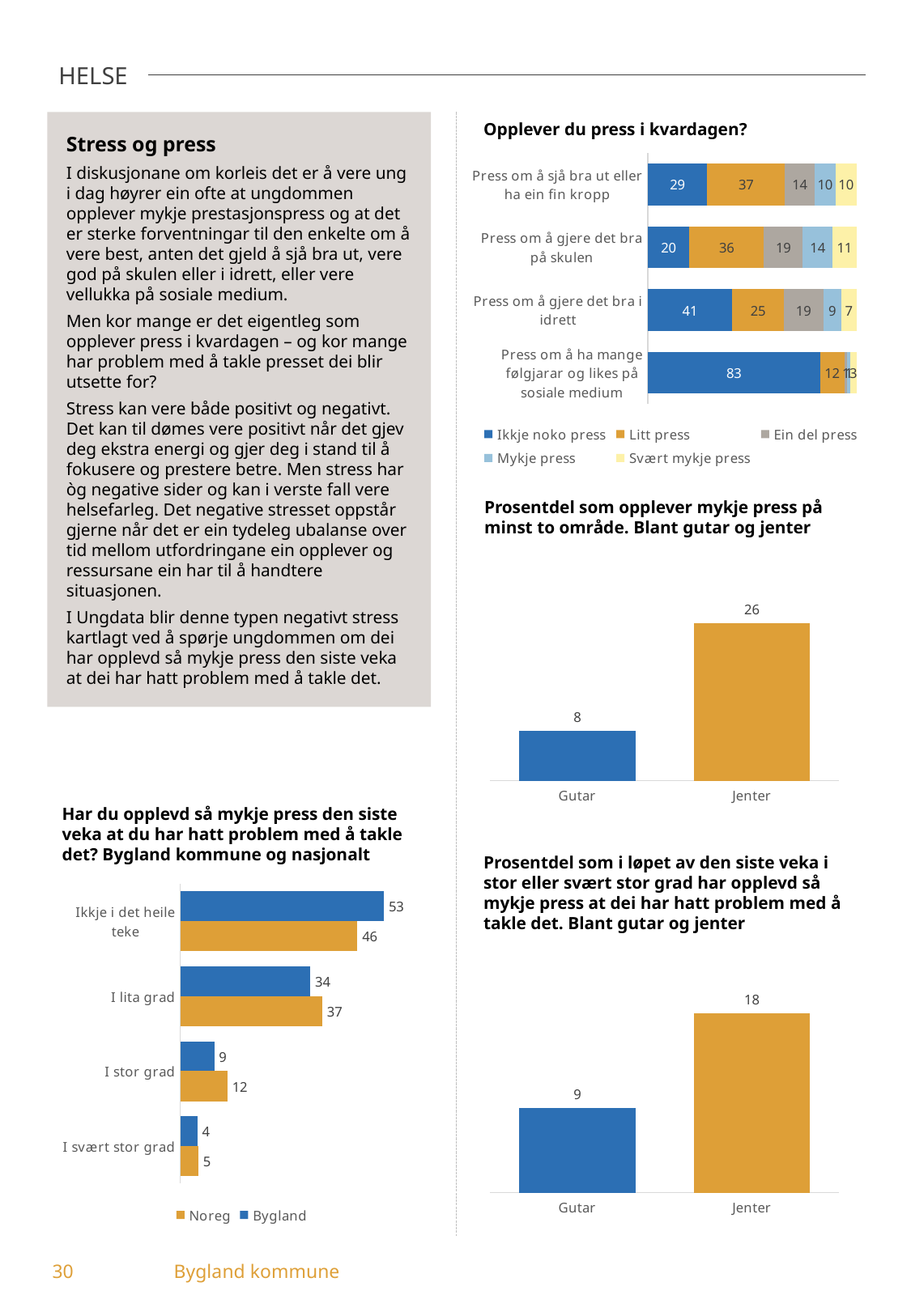
In the chart 'Prosentdel som i løpet av den siste veka i stor eller svært stor grad har opplevd så mykje press...', what is the value for Gutar? 9 In the chart 'Opplever du press i kvardagen?', what is the value for 'Litt press' for 'Press om å gjere det bra på skulen'? 36 In the chart 'Opplever du press i kvardagen?', what is the value for 'Ikkje noko press' for 'Press om å ha mange følgjarar og likes på sosiale medium'? 83 In the chart 'Opplever du press i kvardagen?', how many series does the legend list? 5 In the chart 'Prosentdel som opplever mykje press på minst to område', what is the value for Jenter? 26 In the chart 'Har du opplevd så mykje press den siste veka...', how many categories are shown? 4 In the chart 'Har du opplevd så mykje press den siste veka...', which category has the highest value for Bygland? Ikkje i det heile teke In the chart 'Opplever du press i kvardagen?', what is the total of the stacked bar for 'Press om å sjå bra ut eller ha ein fin kropp'? 100 In the chart 'Har du opplevd så mykje press den siste veka...', what is the value for Noreg for 'I lita grad'? 37 In the chart 'Har du opplevd så mykje press den siste veka...', which is larger for 'I stor grad': Noreg or Bygland? Noreg In the chart 'Prosentdel som opplever mykje press på minst to område', what is the difference between Jenter and Gutar? 18 What kind of chart is 'Prosentdel som i løpet av den siste veka i stor eller svært stor grad har opplevd så mykje press...'? Bar chart